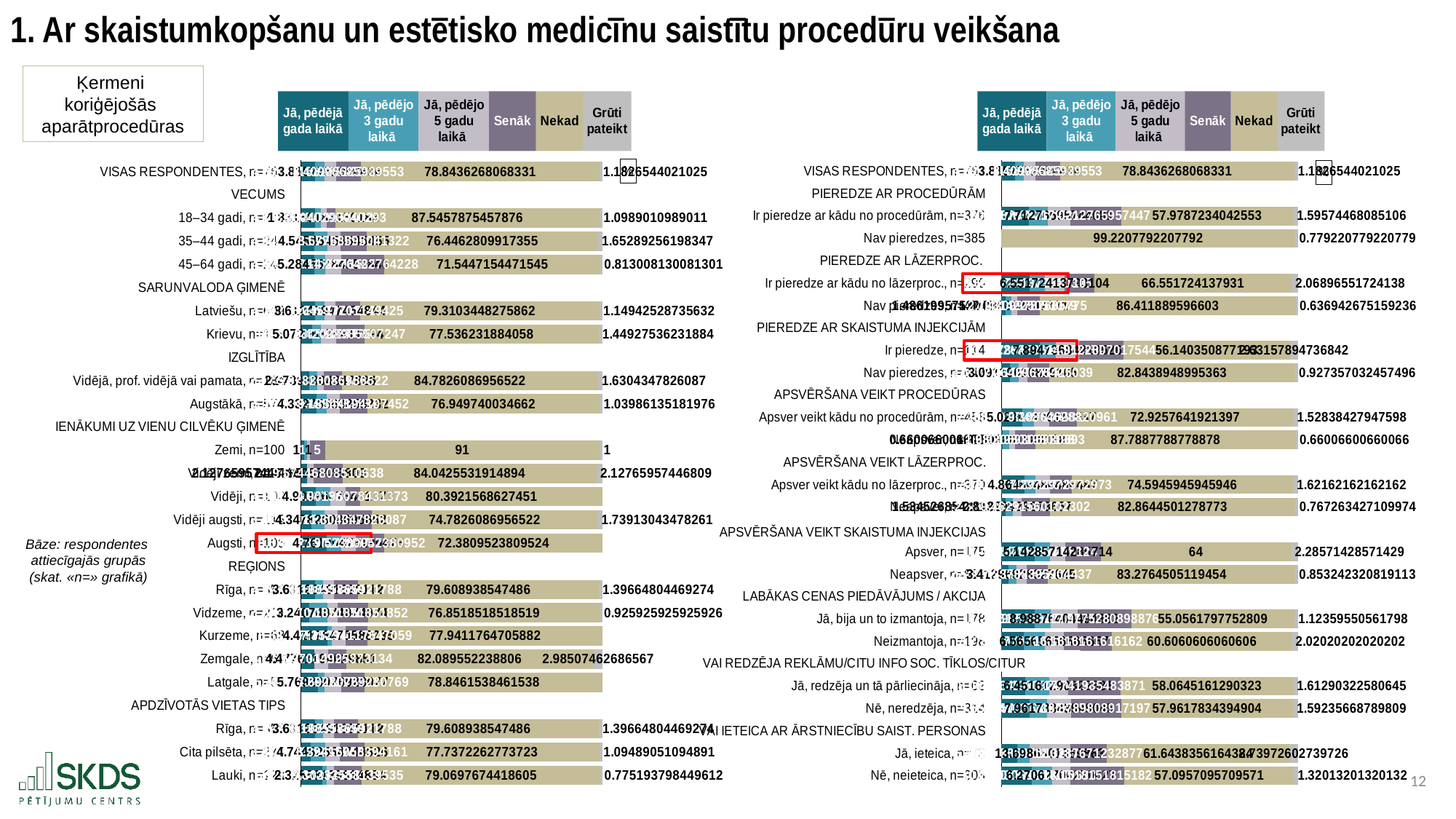
In the right chart, what is the 'Grūti pateikt' value for 'Neizmantoja, n=198'? 2.02020202020202 In the left chart, what is the 'Nekad' value for '18–34 gadi'? 87.5457875457876 In the right chart, which is larger, the 'Nekad' value for 'Ir pieredze ar kādu no procedūrām' or for 'Nav pieredzes, n=385'? Nav pieredzes, n=385 What type of chart is used on this slide? Stacked bar chart How many series does the legend of the left chart list? 6 In the left chart, what is the difference between the 'Nekad' values for 'Zemi, n=100' and 'Augsti'? 18.6190476190476 In the left chart, which age group has the highest 'Nekad' value? 18–34 gadi In the left chart, what is the 'Nekad' value for 'Zemi, n=100'? 91 In the right chart, what is the 'Nekad' value for 'Nav pieredzes, n=385'? 99.2207792207792 In the right chart, what is the 'Nekad' value for 'Apsver, n=175'? 64 In the left chart, which region has the lowest 'Nekad' value? Vidzeme In the left chart, what is the 'Grūti pateikt' value for 'Zemgale'? 2.98507462686567